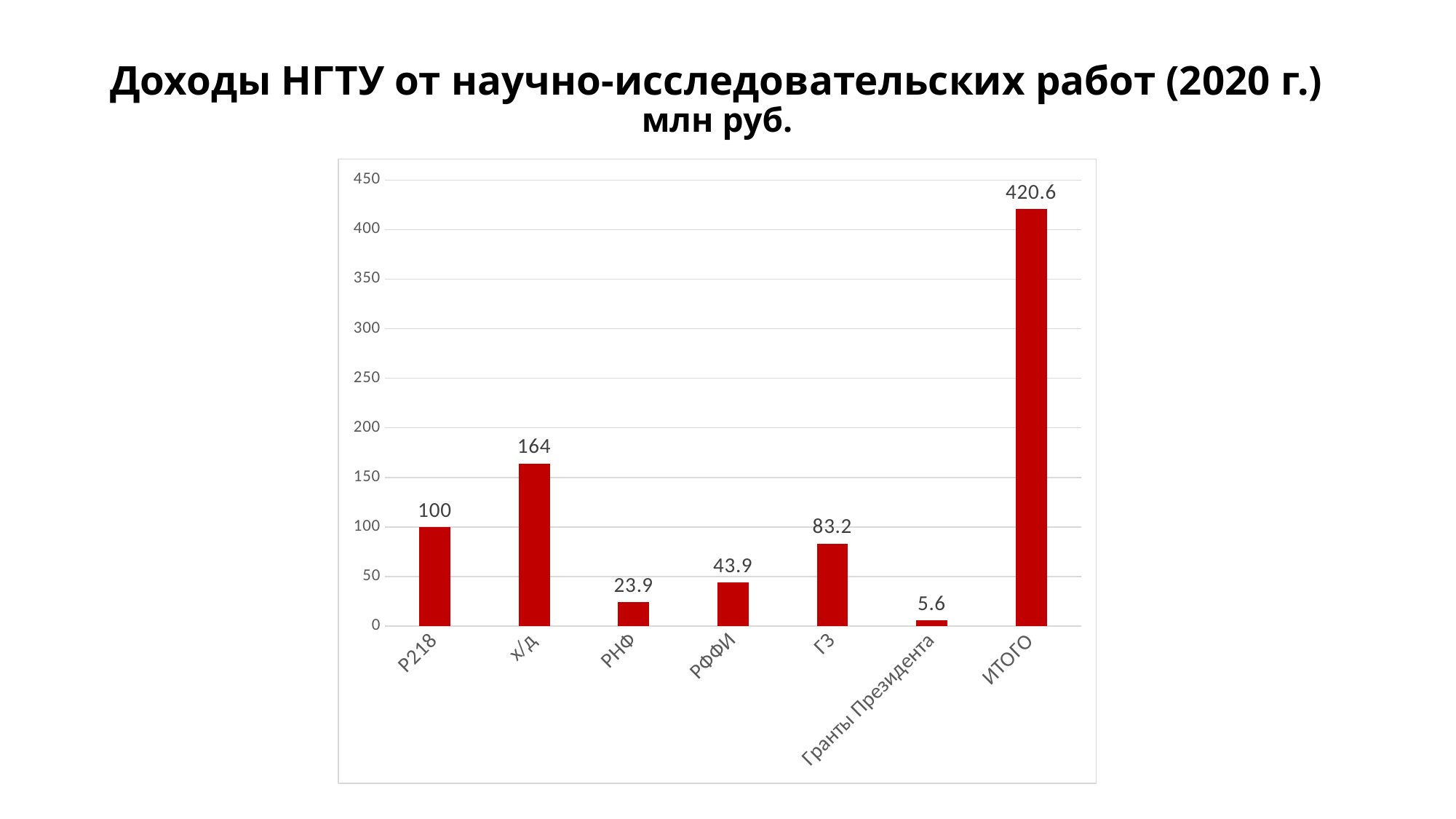
What unit is stated in the chart's subtitle? млн руб. How many categories are shown on the x axis? 7 What kind of chart is shown on the slide? bar chart What is the difference between the values for ГЗ and РНФ? 59.3 Which is larger, the value for РФФИ or the value for РНФ? РФФИ What is the difference between the values for х/д and Р218? 64 What is the value for ИТОГО? 420.6 Which category has the lowest value? Гранты Президента What is the value for Гранты Президента? 5.6 What is the value for РФФИ? 43.9 Which category has the highest value? ИТОГО What is the value for х/д? 164